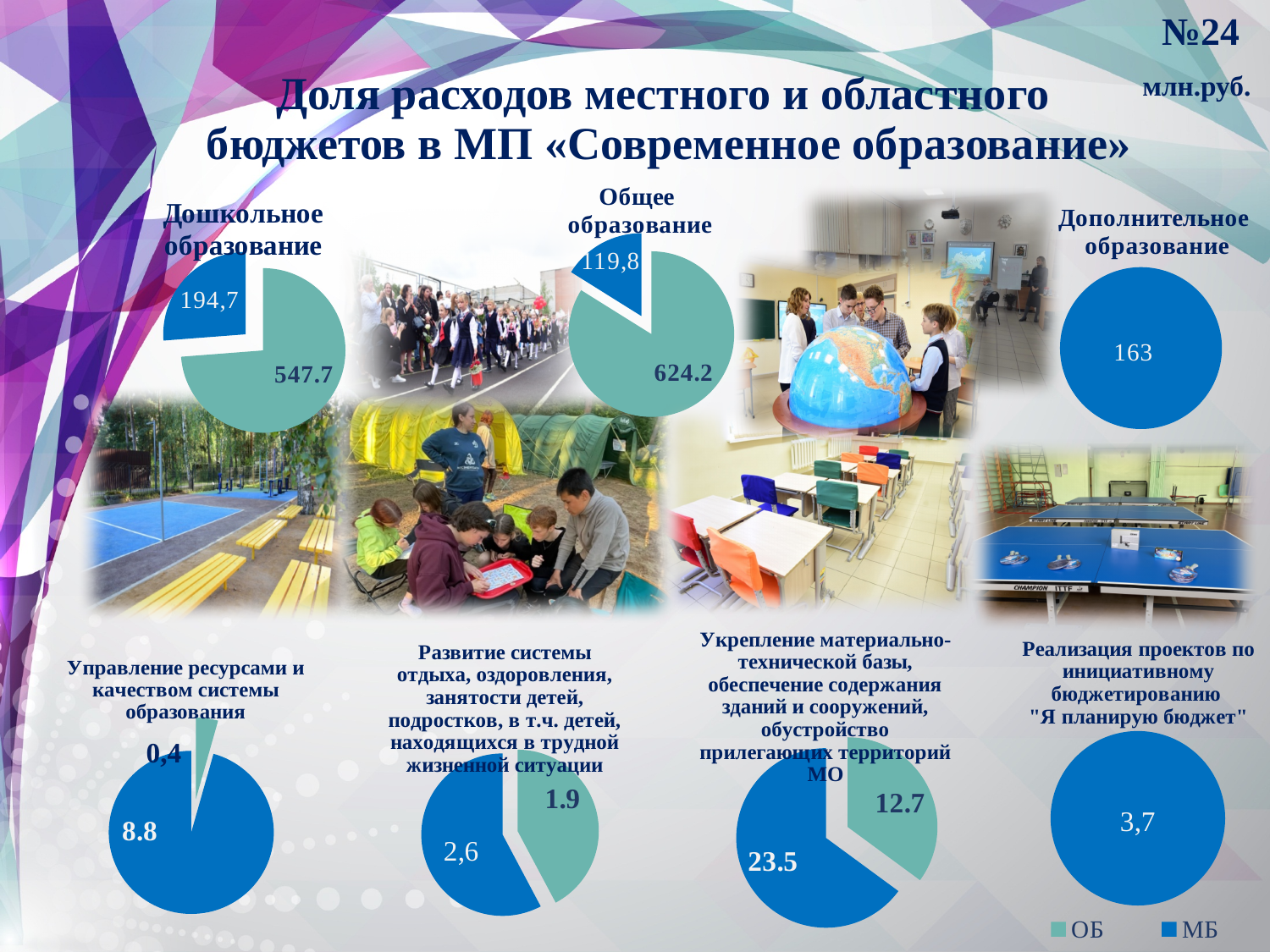
What value is shown in the 'Реализация проектов по инициативному бюджетированию' pie chart? 3,7 In the 'Дошкольное образование' pie chart, what is the value of the МБ (blue) slice? 194,7 In the 'Общее образование' pie chart, what is the value of the МБ slice? 119,8 In the 'Общее образование' pie chart, what is the value of the ОБ slice? 624.2 In the 'Управление ресурсами и качеством системы образования' pie chart, what is the value of the МБ slice? 8.8 What value is shown in the 'Дополнительное образование' pie chart? 163 What type of charts are used on this slide? Pie charts In the 'Дошкольное образование' pie chart, what is the value of the ОБ (teal) slice? 547.7 In the 'Развитие системы отдыха, оздоровления...' pie chart, which is larger: the ОБ slice or the МБ slice? МБ In the 'Укрепление материально-технической базы...' pie chart, what is the difference between the МБ value and the ОБ value? 10.8 How many series does the legend at the bottom of the slide list? 2 In the 'Общее образование' pie chart, what is the difference between the ОБ value and the МБ value? 504.4